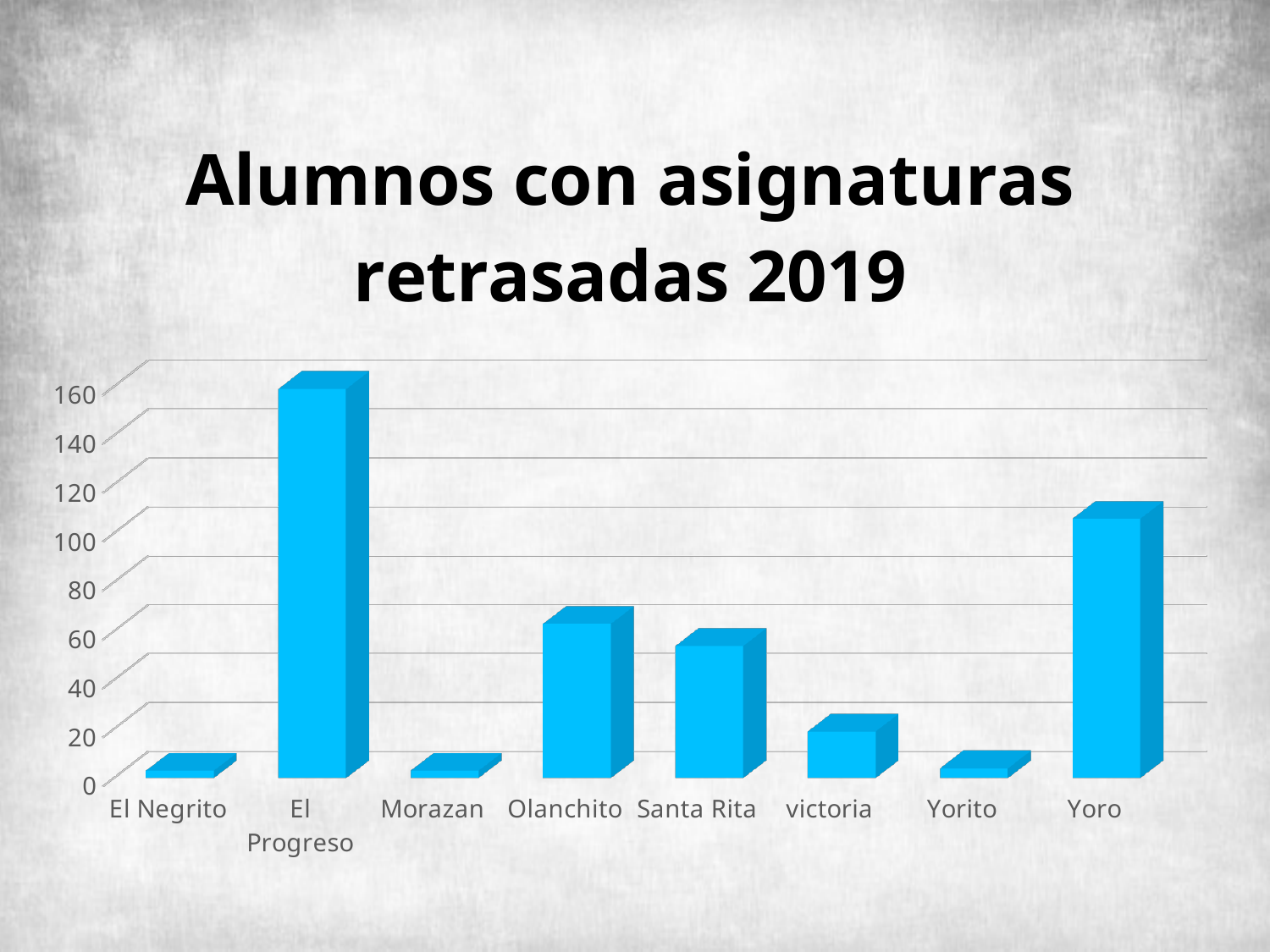
Which is larger, the value for Yoro or the value for Olanchito? Yoro Which is larger, the value for El Progreso or the value for Yoro? El Progreso Is the value for Santa Rita greater or less than 40? greater Is the value for El Progreso greater or less than 140? greater How many categories are shown on the x axis of the chart? 8 What is the title of the chart? Alumnos con asignaturas retrasadas 2019 Is the value for Olanchito greater or less than 80? less Which is larger, the value for Santa Rita or the value for victoria? Santa Rita Which category has the highest value in the chart? El Progreso What kind of chart is shown on the slide? bar chart